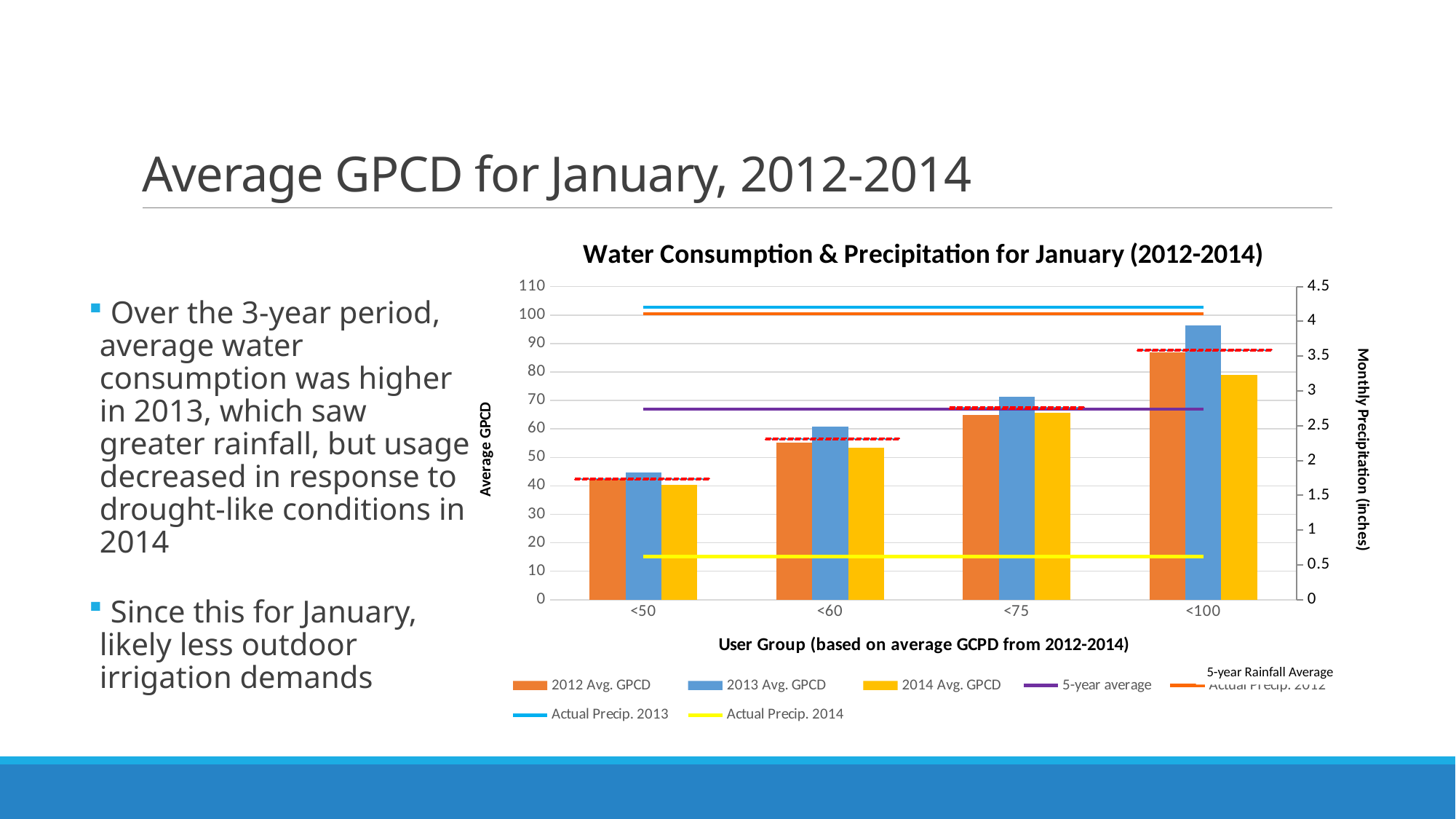
Which user group has the lowest 2014 Avg. GPCD bar? <50 Do the 2013 Avg. GPCD bars rise or fall from the <50 group to the <100 group? rise Is the 2014 Avg. GPCD value for the <60 user group greater or less than 60? less What is the label of the right-hand vertical axis? Monthly Precipitation (inches) Is the 2012 Avg. GPCD value for the <75 user group greater or less than 60? greater What is the title of the chart? Water Consumption & Precipitation for January (2012-2014) Which user group has the highest 2013 Avg. GPCD bar? <100 Is the 2013 Avg. GPCD value for the <100 user group greater or less than 90? greater How many user groups are shown on the x axis? 4 For the <100 user group, which is larger: the 2013 Avg. GPCD or the 2014 Avg. GPCD? 2013 Avg. GPCD What kind of chart is shown on the slide? combination bar and line chart